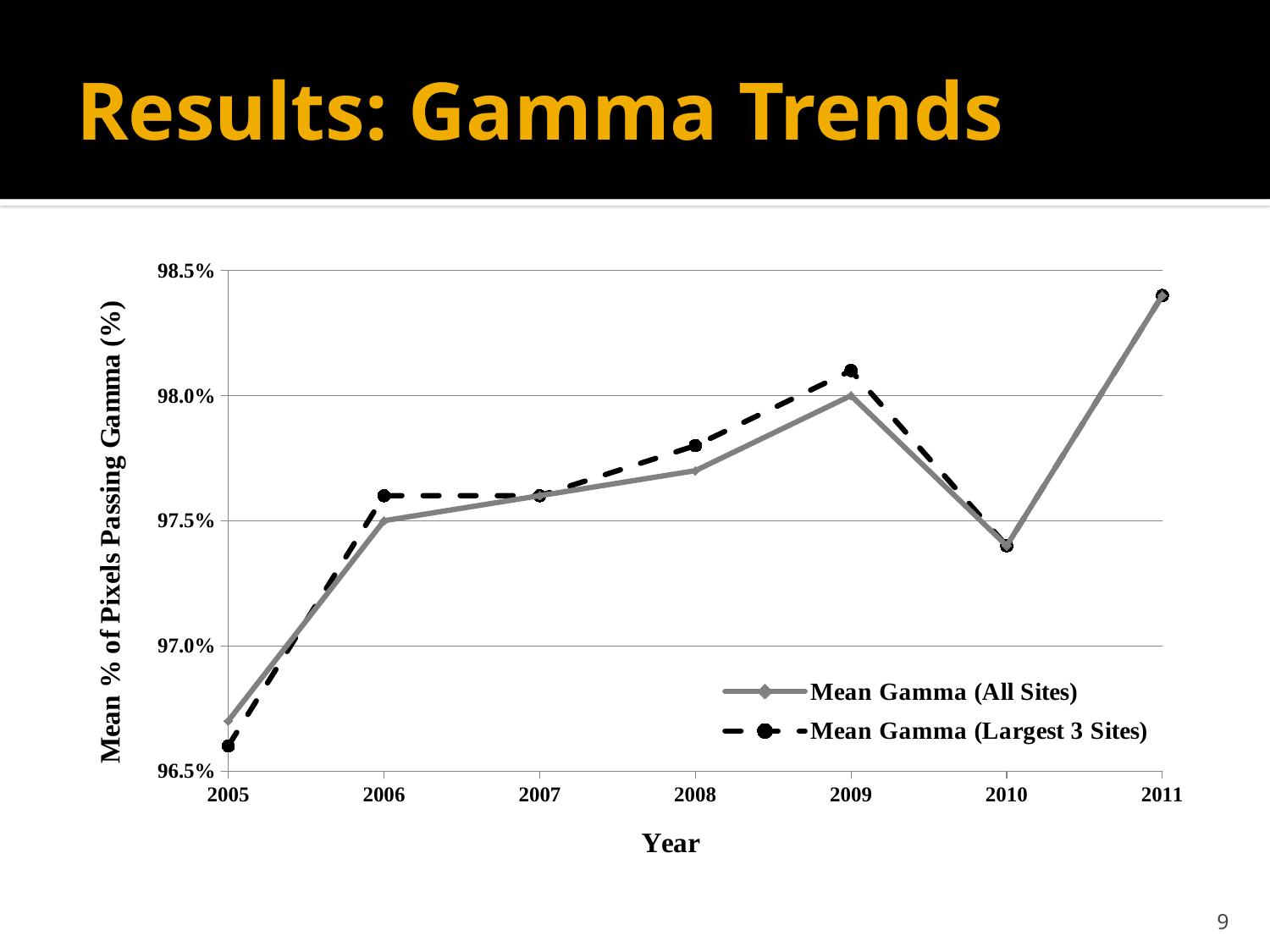
Is the Mean Gamma (All Sites) value for 2005 greater or less than 97.0%? less Is the Mean Gamma (All Sites) value for 2010 greater or less than 97.5%? less Does the Mean Gamma (All Sites) series rise or fall from 2005 to 2009? rise How many series does the legend list? 2 Which year has the larger Mean Gamma (All Sites) value, 2009 or 2010? 2009 Is the Mean Gamma (All Sites) value for 2011 greater or less than 98.0%? greater How many years are plotted along the x axis? 7 In which year is the Mean Gamma (All Sites) value lowest? 2005 What kind of chart is shown on the slide? line chart In which year is the Mean Gamma (All Sites) value highest? 2011 What is the title of the y axis? Mean % of Pixels Passing Gamma (%)